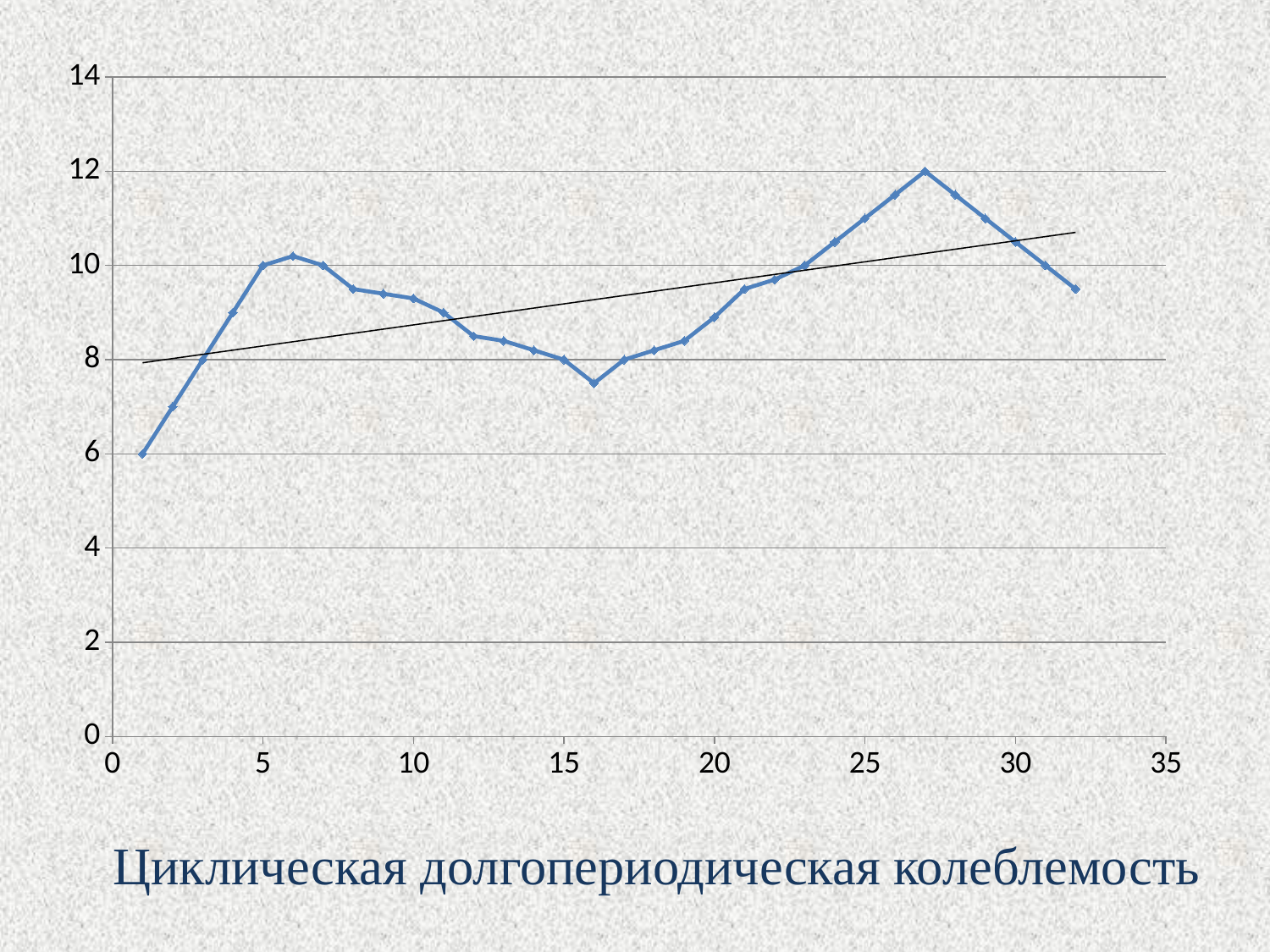
Does the straight trend line rise or fall from left to right? rises Is the value of the plotted line at x = 16 greater or less than 8? less What is the value of the plotted line at x = 5? 10 What is the value of the plotted line at x = 1? 6 At which x value does the plotted line reach its highest point? 27 Is the value of the plotted line at x = 24 greater or less than 10? greater At which x value does the plotted line have its lowest point? 1 Which is larger: the value at x = 4 or the value at x = 16? x = 4 Is the value of the plotted line at x = 2 greater or less than 8? less What is the value of the plotted line at x = 27? 12 What kind of chart is shown on the slide? line chart